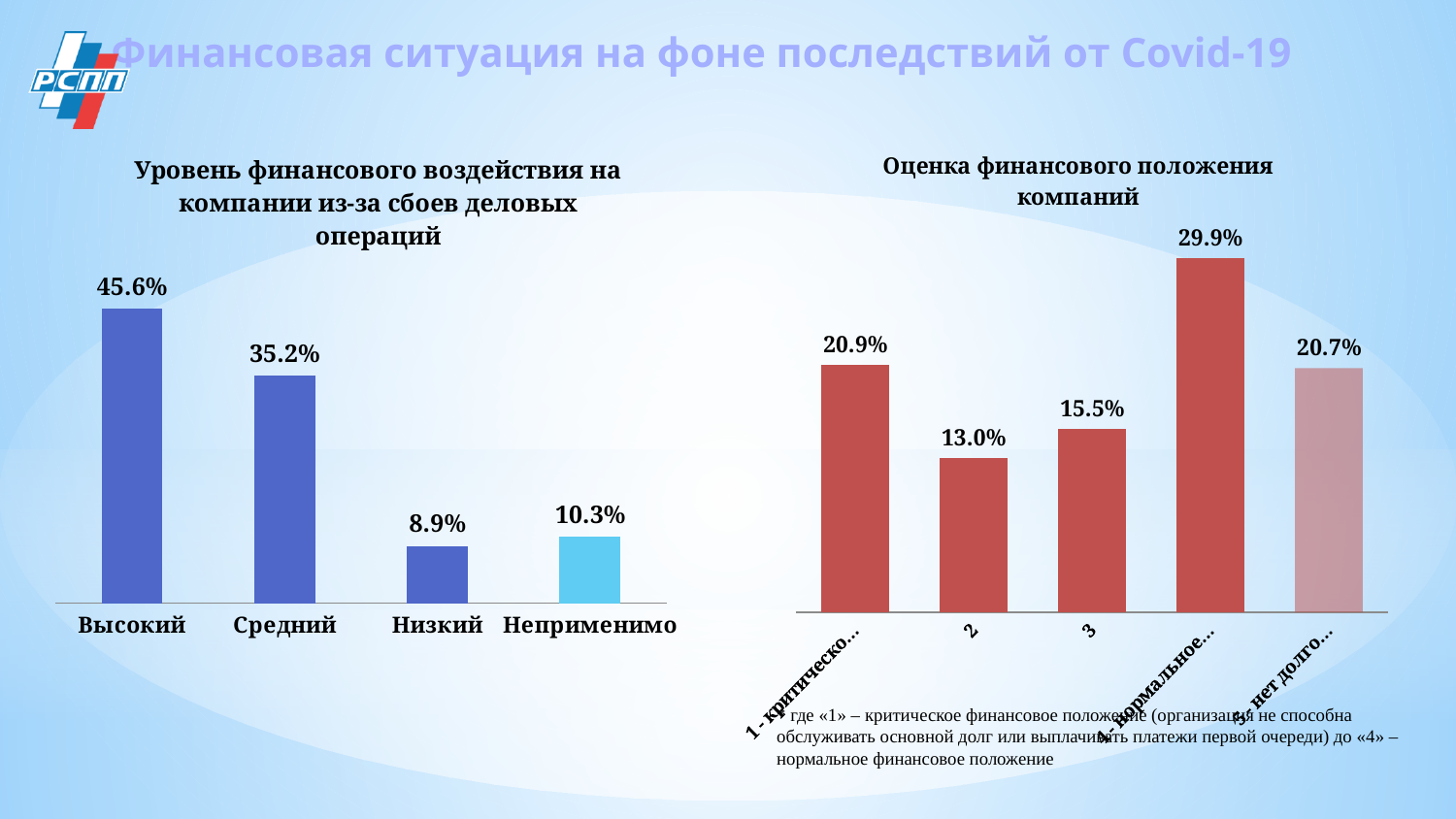
How many categories are shown in the left chart (Уровень финансового воздействия)? 4 In the right chart (Оценка финансового положения компаний), what is the highest value shown? 29.9% In the right chart (Оценка финансового положения компаний), what is the value for category 3? 15.5% In the right chart (Оценка финансового положения компаний), what is the difference between category 3 and category 2? 2.5% In the left chart (Уровень финансового воздействия), which category has the lowest value? Низкий In the right chart (Оценка финансового положения компаний), what is the value for category 2? 13.0% In the left chart (Уровень финансового воздействия), what is the value for Неприменимо? 10.3% In the left chart (Уровень финансового воздействия на компании из-за сбоев деловых операций), what is the value for Высокий? 45.6% In the left chart (Уровень финансового воздействия), which is larger: Низкий or Неприменимо? Неприменимо What type of chart is the right chart (Оценка финансового положения компаний)? Bar chart In the left chart (Уровень финансового воздействия), what is the difference between Высокий and Средний? 10.4% In the left chart (Уровень финансового воздействия), what is the value for Средний? 35.2%